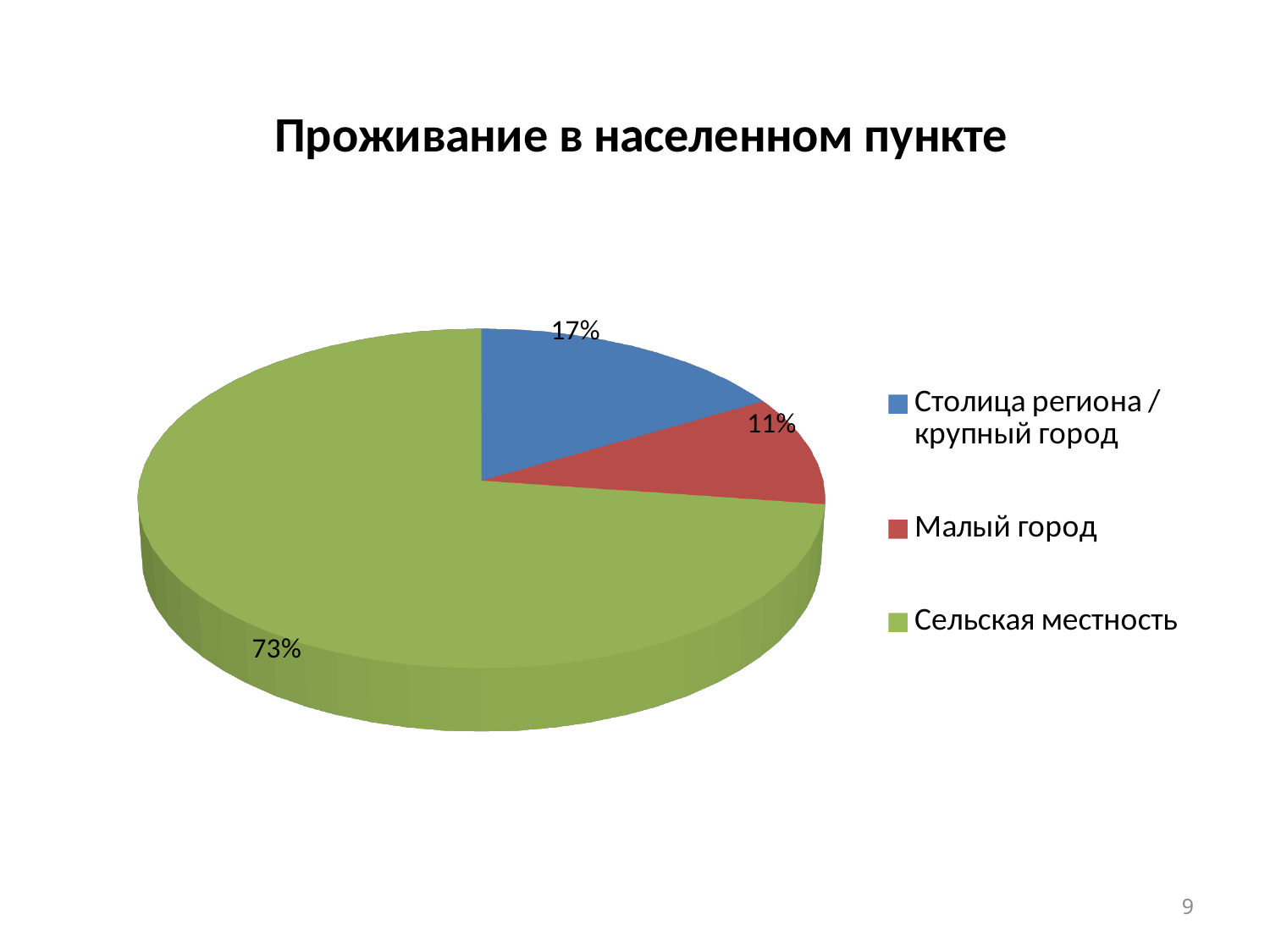
What is the difference between the shares of Столица региона / крупный город and Малый город? 6% Which category has the largest slice? Сельская местность What is the value for Малый город? 11% What is the title of the chart? Проживание в населенном пункте Which is larger, the share for Столица региона / крупный город or for Малый город? Столица региона / крупный город Which category has the smallest slice? Малый город What is the value for Столица региона / крупный город? 17% What kind of chart is shown on the slide? Pie chart What share of the pie does Сельская местность represent? 73% How many categories does the pie chart show? 3 What colour is the slice for Малый город? Red What is the difference between the shares of Сельская местность and Столица региона / крупный город? 56%